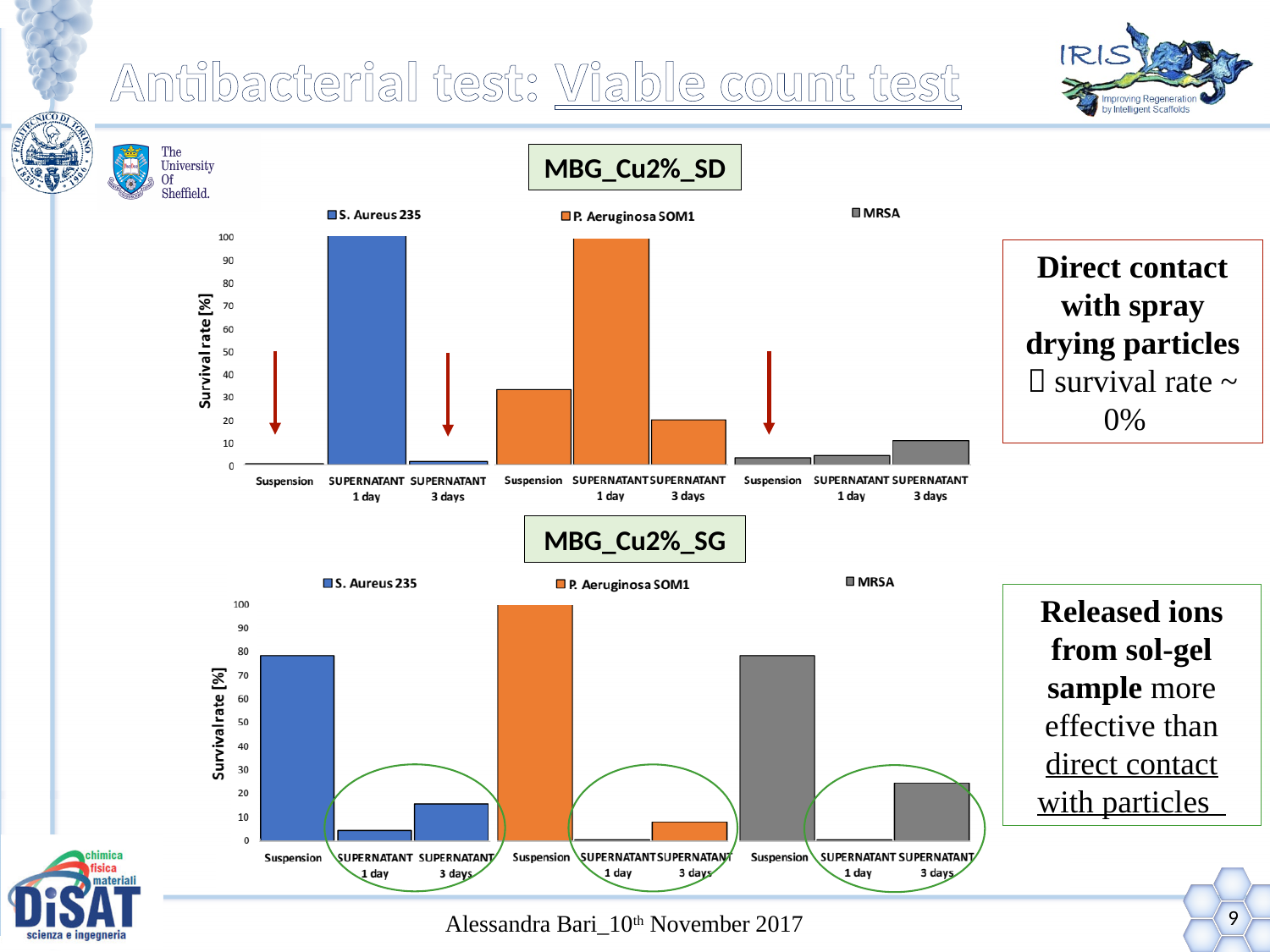
How many series does the legend of the MBG_Cu2%_SD chart list? 3 On the MBG_Cu2%_SD chart, which is larger for P. Aeruginosa SOM1: the Suspension value or the SUPERNATANT 3 days value? Suspension What kind of chart is the MBG_Cu2%_SG chart? Bar chart On the MBG_Cu2%_SG chart, is the survival rate for S. Aureus 235 in Suspension greater or less than 60? greater On the MBG_Cu2%_SG chart, which is larger for MRSA: the SUPERNATANT 1 day value or the SUPERNATANT 3 days value? SUPERNATANT 3 days On the MBG_Cu2%_SD chart, what is the survival rate for S. Aureus 235 in the SUPERNATANT 1 day condition? 100 On the MBG_Cu2%_SG chart, is the survival rate for MRSA in the SUPERNATANT 3 days condition greater or less than 10? greater On the MBG_Cu2%_SD chart, which condition gives the highest survival rate for S. Aureus 235? SUPERNATANT 1 day On the MBG_Cu2%_SG chart, what is the survival rate for P. Aeruginosa SOM1 in the Suspension condition? 100 On the MBG_Cu2%_SG chart, which condition gives the highest survival rate for P. Aeruginosa SOM1? Suspension On the MBG_Cu2%_SD chart, is the survival rate for P. Aeruginosa SOM1 in Suspension greater or less than 20? greater On the MBG_Cu2%_SG chart, which condition gives the lowest survival rate for S. Aureus 235? SUPERNATANT 1 day